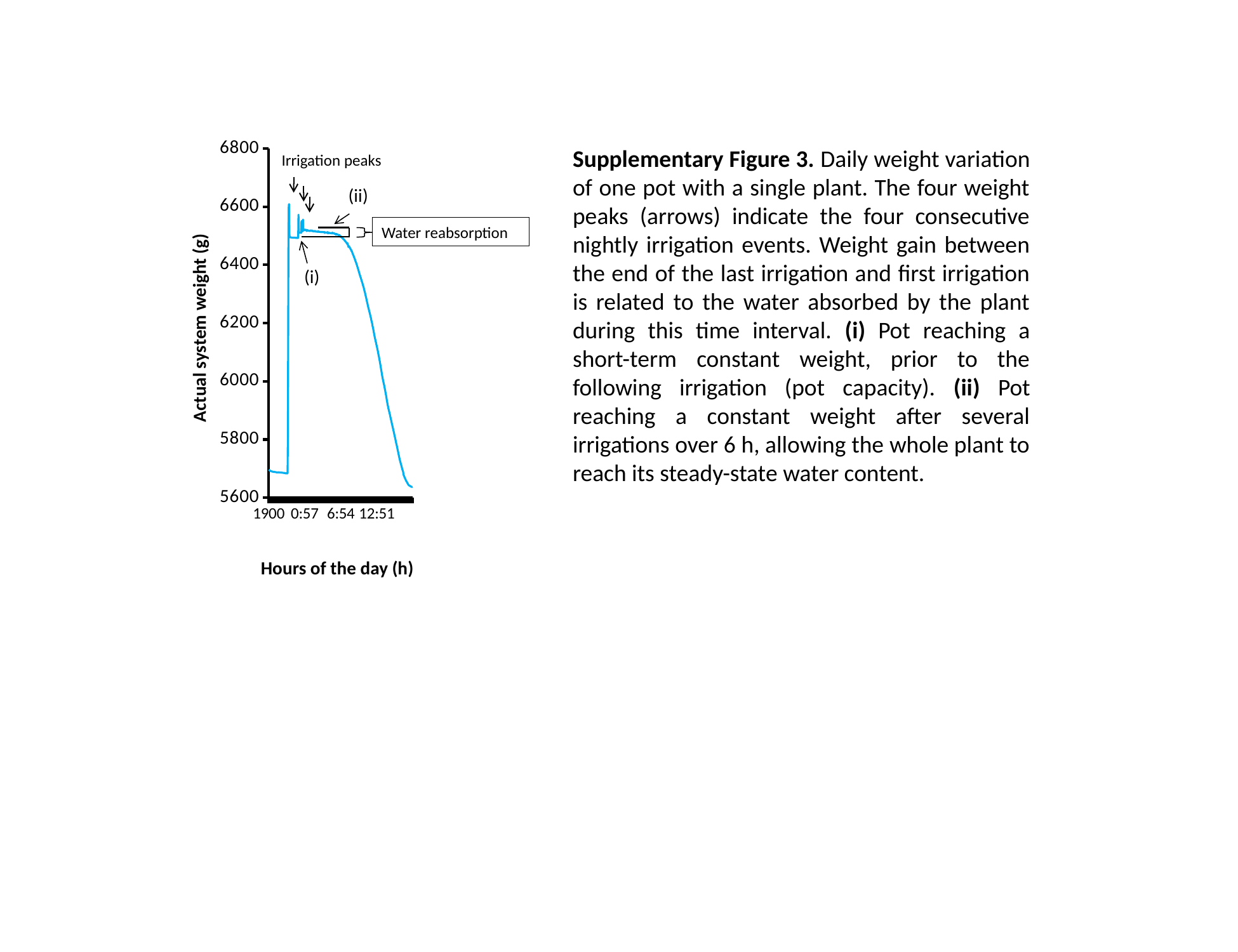
Is the system weight at 1900 greater or less than 5800 g? less Does the system weight rise or fall between 6:54 and 12:51? fall What is the label of the x axis of the chart? Hours of the day (h) Is the system weight at 6:54 greater or less than 6400 g? greater How many tick labels are shown on the x axis of the chart? 4 What kind of chart is shown on the slide? line chart Which is larger, the system weight at 1900 or at 0:57? 0:57 What is the highest value shown on the y axis of the chart? 6800 Which is larger, the system weight at 6:54 or at 12:51? 6:54 Is the highest irrigation peak greater or less than 6400 g? greater What is the label of the y axis of the chart? Actual system weight (g) What is the lowest value shown on the y axis of the chart? 5600